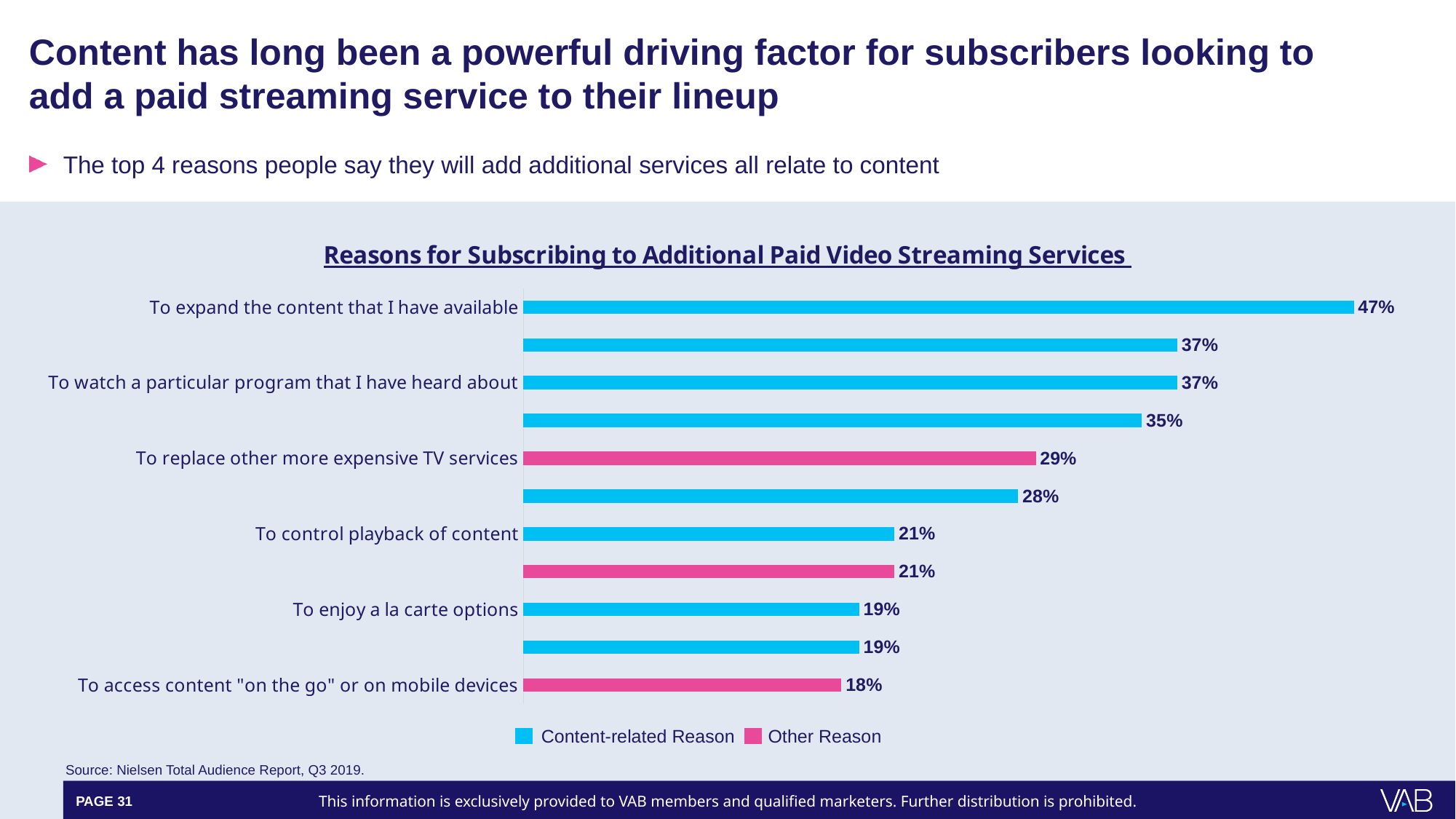
What is the value for "To access content "on the go" or on mobile devices"? 18% What is the value for "To replace other more expensive TV services"? 29% What type of chart is shown on the slide? Bar chart What is the value for "To watch a particular program that I have heard about"? 37% How many series does the legend list? 2 Which labeled reason has the lowest percentage? To access content "on the go" or on mobile devices What percentage of respondents cited "To expand the content that I have available" as a reason? 47% What is the title of the chart? Reasons for Subscribing to Additional Paid Video Streaming Services Which is larger: the value for "To replace other more expensive TV services" or the value for "To control playback of content"? To replace other more expensive TV services How many bars are plotted in the chart? 11 Which reason has the highest percentage? To expand the content that I have available What is the difference in percentage points between "To expand the content that I have available" and "To watch a particular program that I have heard about"? 10 percentage points